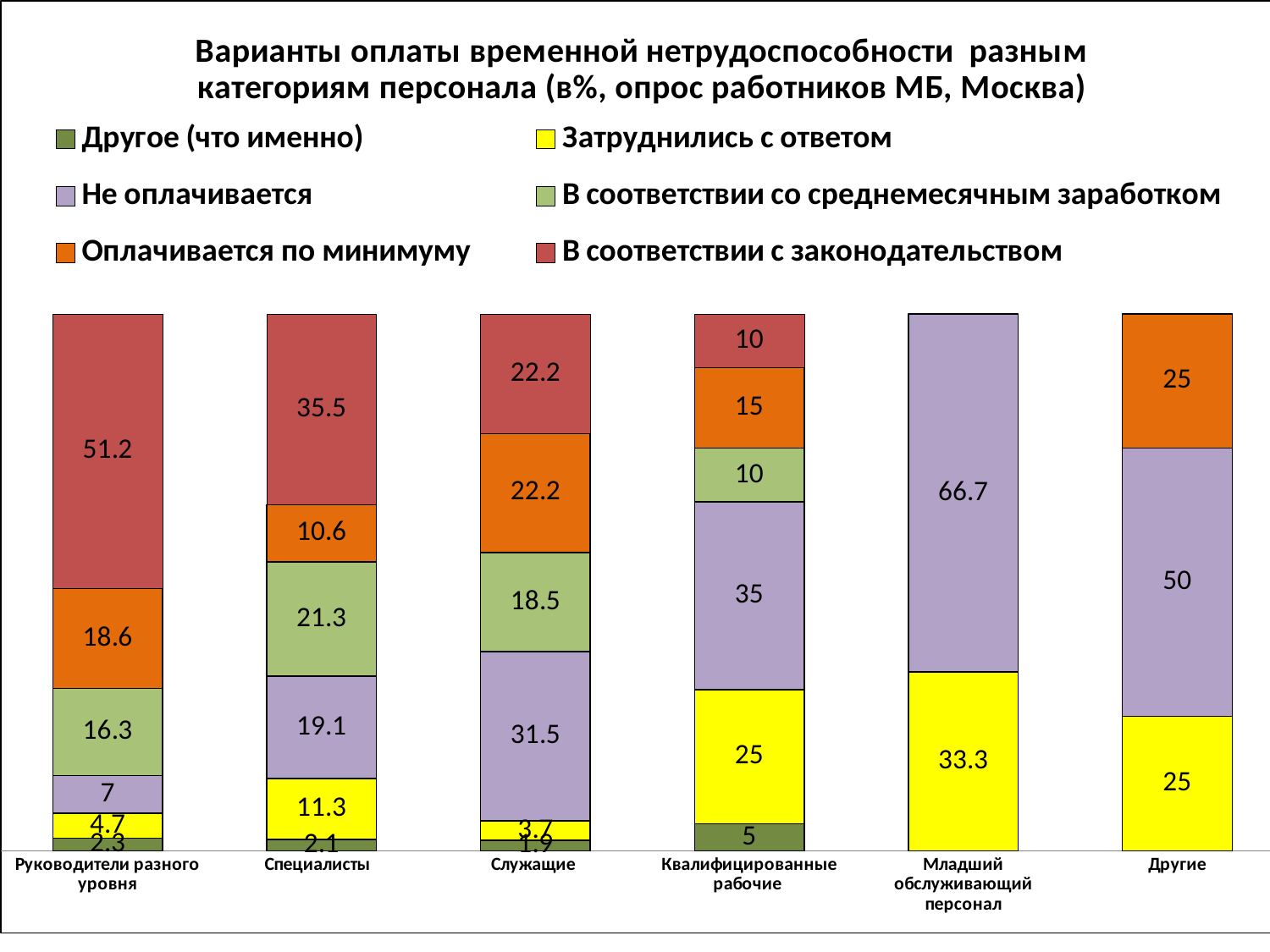
Which category has the highest value for 'В соответствии с законодательством'? Руководители разного уровня What is the value of 'В соответствии с законодательством' for 'Руководители разного уровня'? 51.2 What is the difference between 'Не оплачивается' for 'Квалифицированные рабочие' and for 'Специалисты'? 15.9 What is the value of 'Оплачивается по минимуму' for 'Другие'? 25 What is the total of the stacked bar for 'Другие'? 100 Which is larger for 'Служащие': 'Не оплачивается' or 'В соответствии со среднемесячным заработком'? Не оплачивается How many series does the legend list? 6 What is the value of 'Не оплачивается' for 'Младший обслуживающий персонал'? 66.7 Which category has the lowest value for 'Другое (что именно)' among those where it is shown? Служащие How many personnel categories are shown along the x axis? 6 What kind of chart is shown on the slide? stacked bar chart What is the value of 'Затруднились с ответом' for 'Специалисты'? 11.3